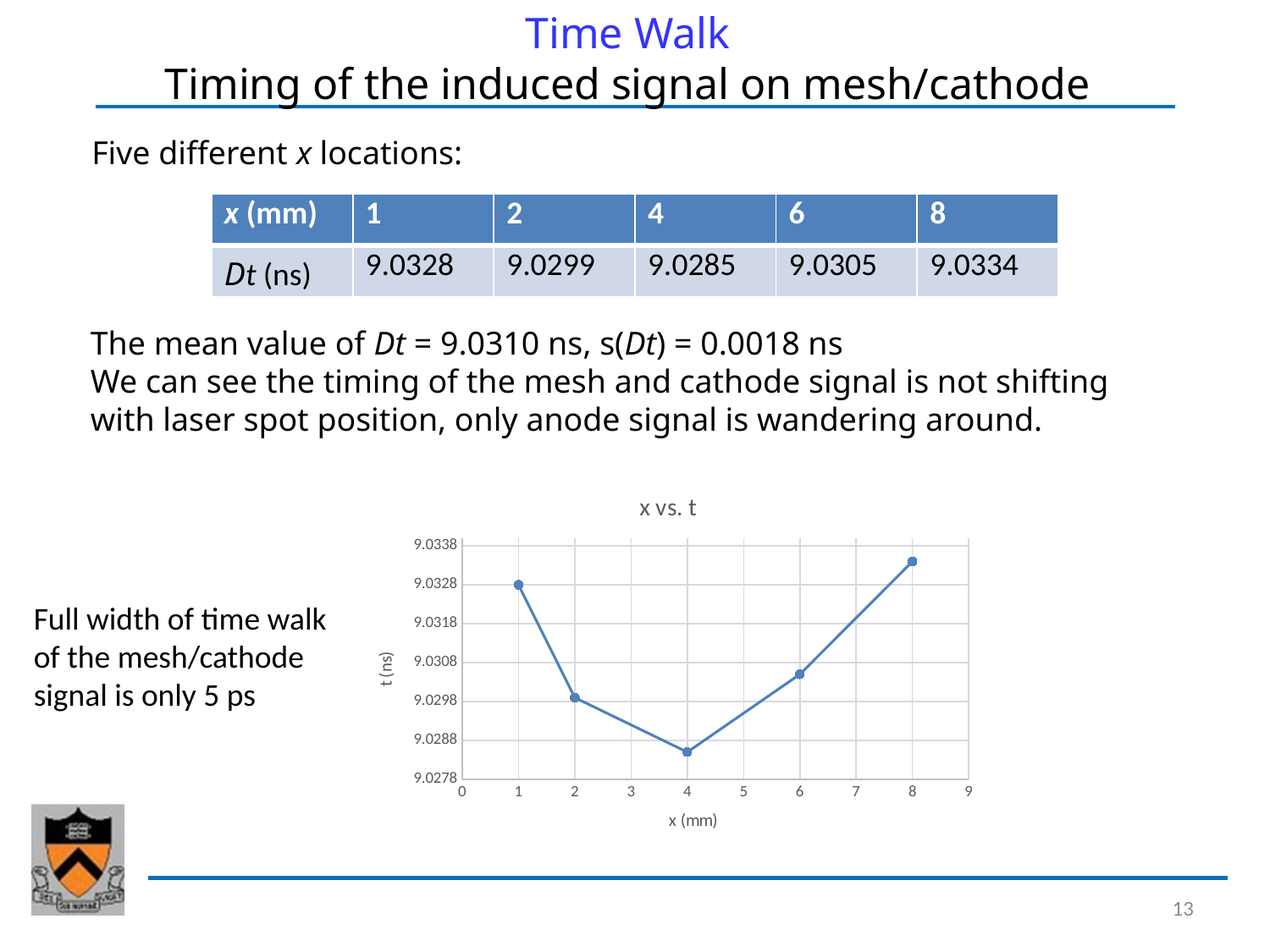
What kind of chart is shown on the slide? line chart What is the value of t (ns) at x = 4 mm? 9.0285 Is the value of t at x = 8 mm greater or less than 9.0328? greater At which x (mm) value is t (ns) highest in the chart? 8 Is the value of t at x = 6 mm greater or less than 9.0308? less What is the difference between the t values at x = 8 mm and x = 4 mm? 0.0049 Which has the larger t value, x = 2 mm or x = 6 mm? x = 6 mm At which x (mm) value is t (ns) lowest in the chart? 4 What is the value of t (ns) at x = 1 mm? 9.0328 What is the title of the chart? x vs. t How many data points are plotted in the chart? 5 What is the label of the vertical axis of the chart? t (ns)